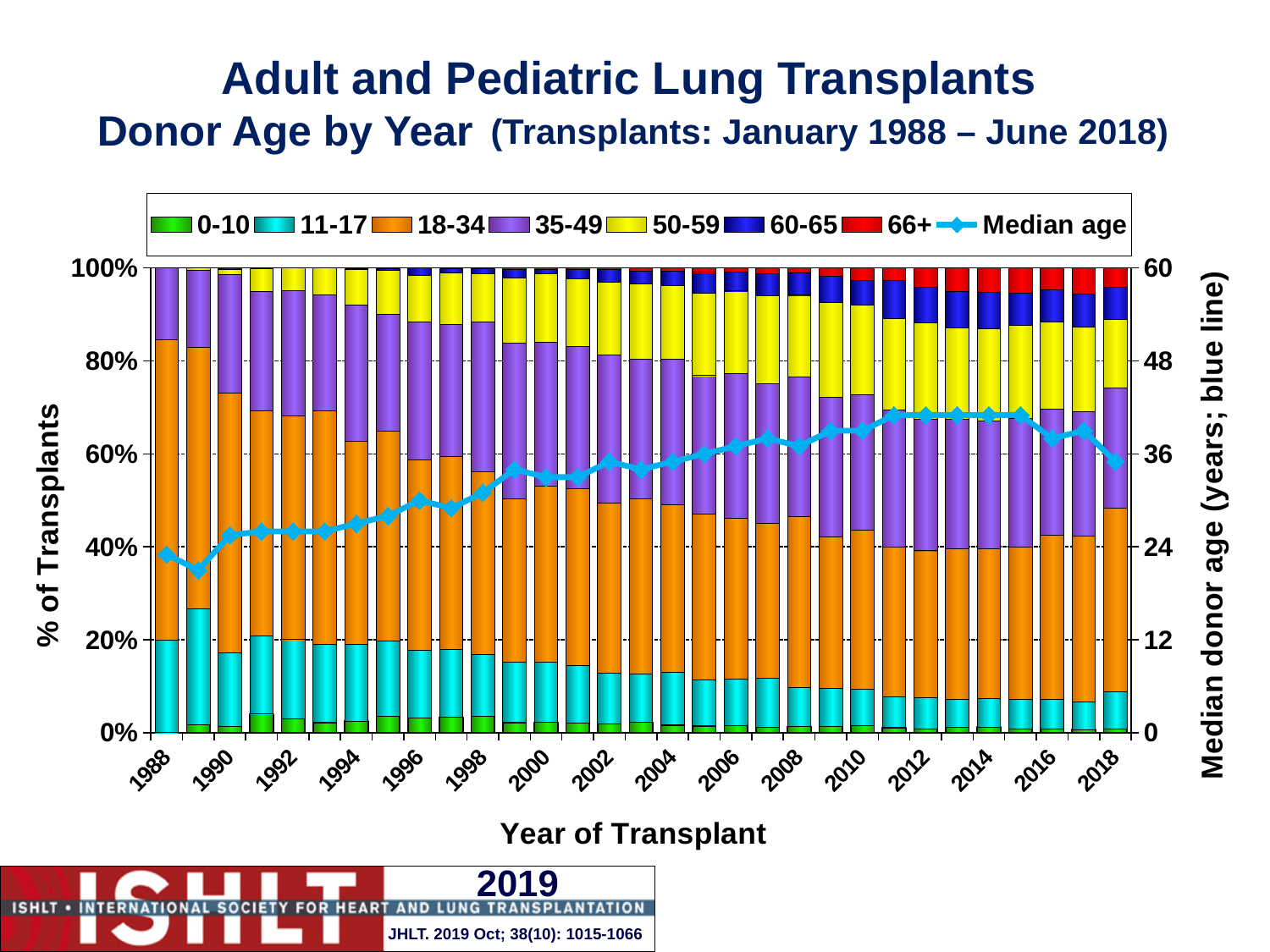
Is the median donor age in 1989 greater or less than 24 years? less Is the share of transplants with donors aged 18-34 in 2014 greater or less than 40%? less What is the title of the right-hand y axis? Median donor age (years; blue line) Which year has the lowest median donor age? 1989 Is the median donor age higher in 2012 or in 1990? 2012 What kind of chart is shown on the slide? Stacked bar chart with a line Is the median donor age in 2012 greater or less than 36 years? greater Which donor age group is shown in red in the legend? 66+ How many entries does the legend list? 8 How many years (bars) are plotted along the x axis? 31 Overall, does the median donor age rise or fall from 1988 to 2012? rise